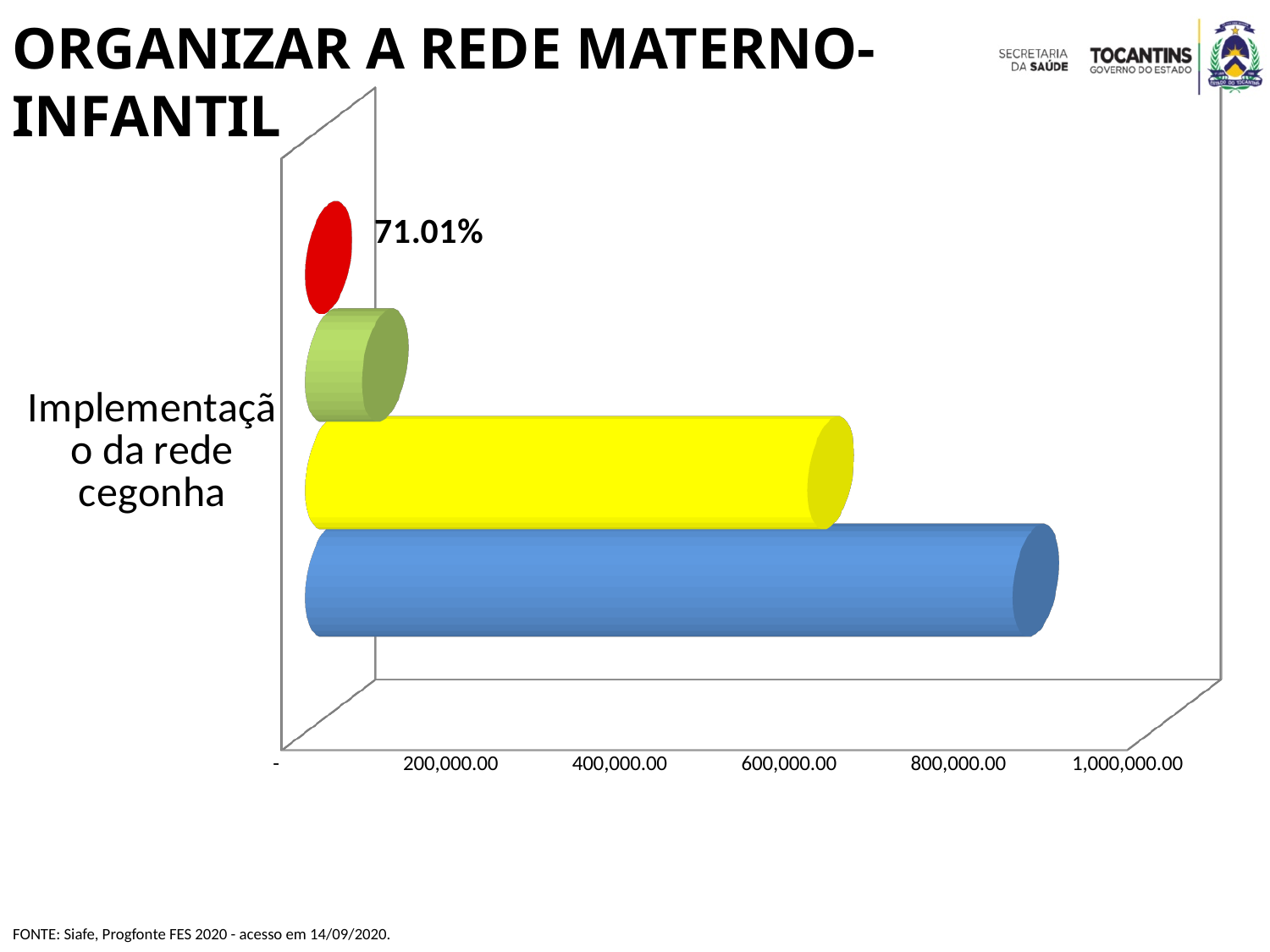
Which coloured bar is the shortest on the chart? red Which is larger, the blue bar or the yellow bar? blue bar Is the value of the blue bar greater or less than 800,000.00? greater What percentage is printed as a data label on the chart? 71.01% Is the value of the green bar greater or less than 200,000.00? less What kind of chart is shown on the slide? bar chart How many bars are plotted for the category Implementação da rede cegonha? 4 What is the name of the category shown on the chart? Implementação da rede cegonha Which coloured bar is the longest on the chart? blue What is the highest value shown on the chart's horizontal axis? 1,000,000.00 How many categories are shown on the chart's vertical axis? 1 Is the value of the yellow bar greater or less than 800,000.00? less